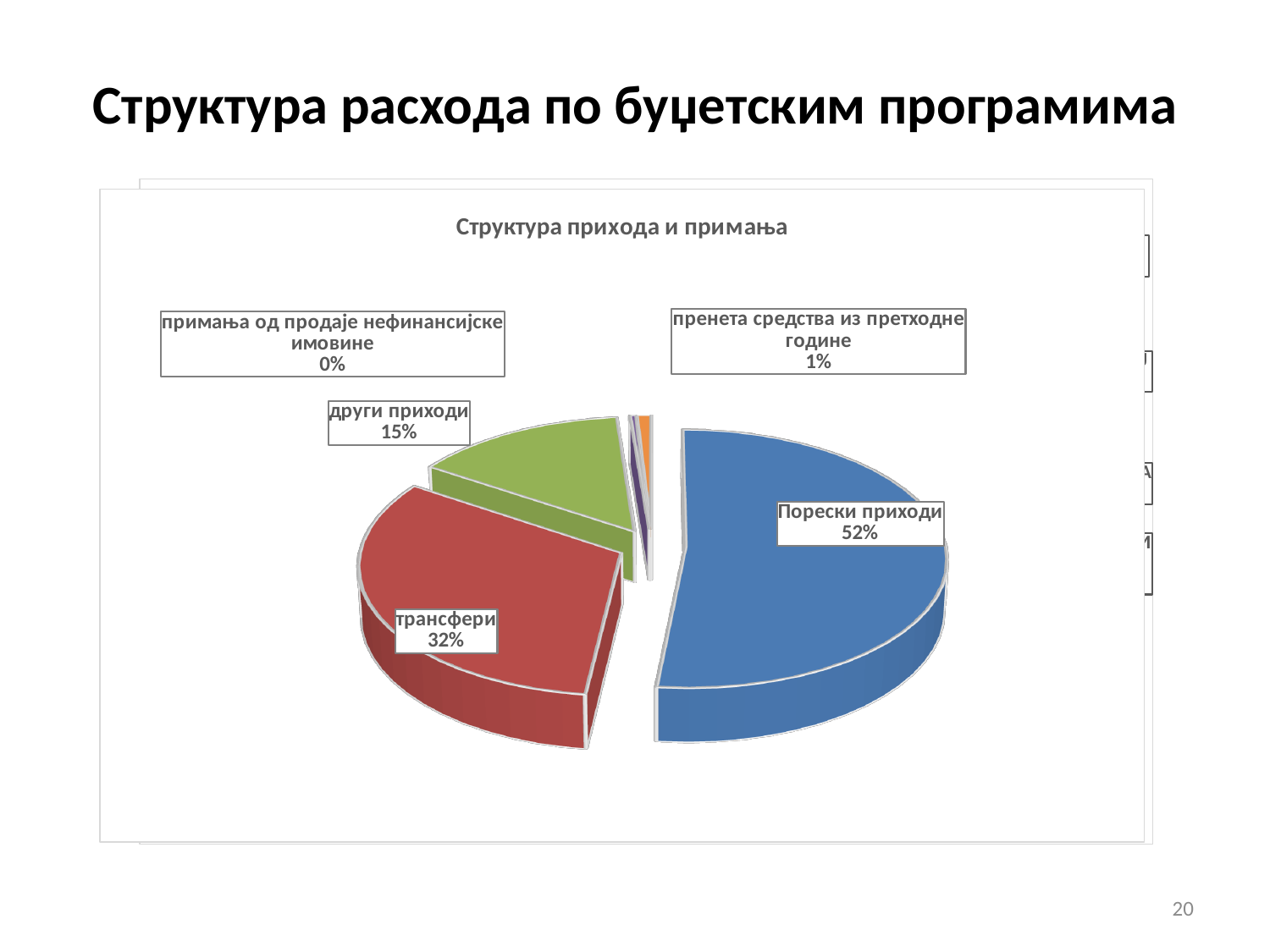
What share of the pie is пренета средства из претходне године? 1% What share of the pie is Порески приходи? 52% What share of the pie is примања од продаје нефинансијске имовине? 0% Which category has the smallest share of the pie? примања од продаје нефинансијске имовине Which is larger, the share of трансфери or the share of други приходи? трансфери What is the title of the chart? Структура прихода и примања What kind of chart is shown on the slide? Pie chart Which category has the largest share of the pie? Порески приходи What is the difference between the shares of Порески приходи and трансфери? 20% How many categories are labelled in the pie chart? 5